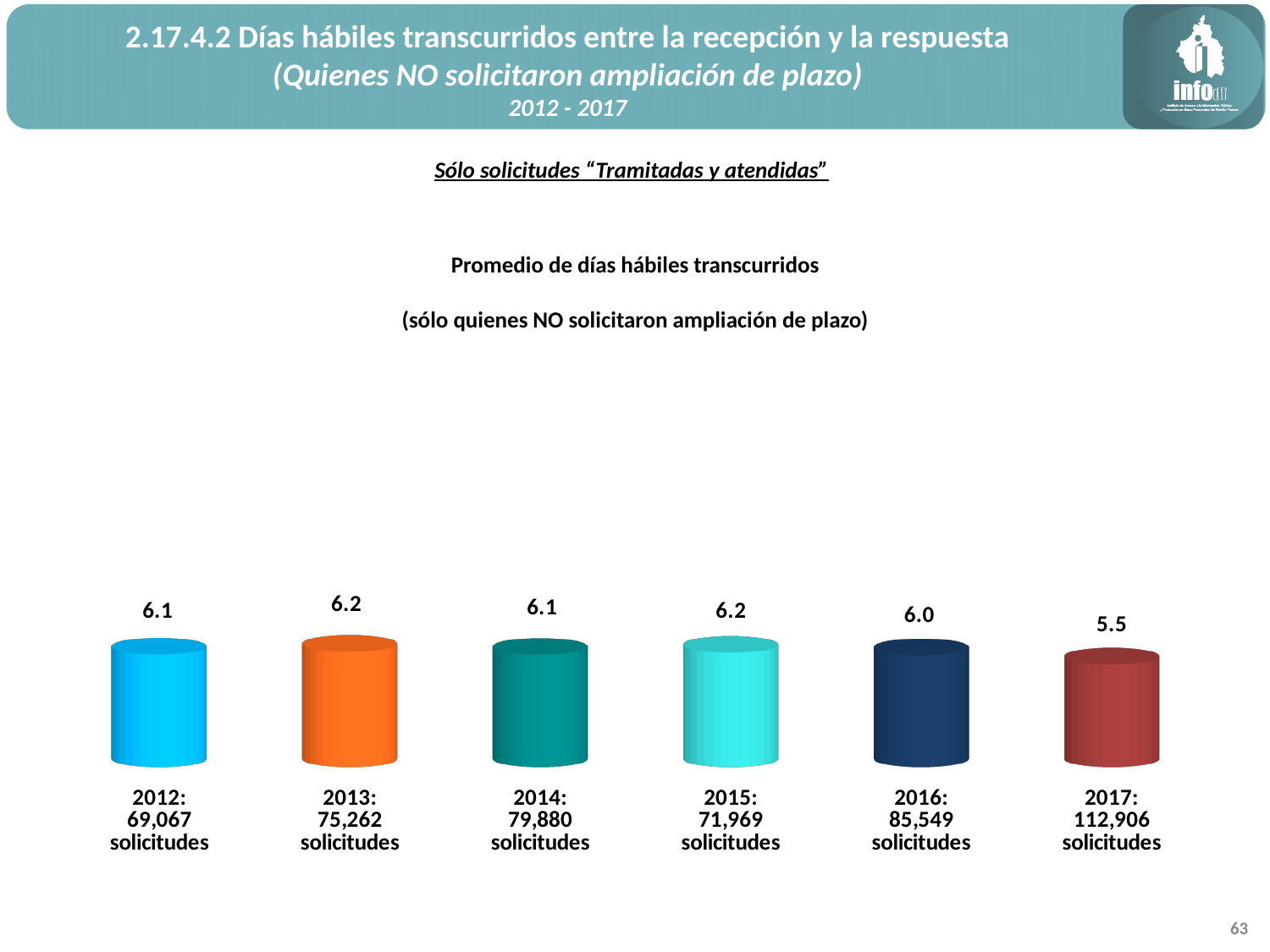
What kind of chart is shown on the slide? bar chart Which year has the lowest average number of business days elapsed? 2017 What is the average number of business days elapsed for 2016? 6.0 Which is larger, the average days for 2015 or for 2016? 2015 What colour is the bar for 2013? orange What is the difference between the average days for 2013 and 2017? 0.7 How many solicitudes are reported for 2017? 112,906 What is the average number of business days elapsed for 2012? 6.1 How many years are shown in the chart? 6 What is the average number of business days elapsed for 2017? 5.5 What is the difference between the average days for 2016 and 2017? 0.5 How many solicitudes are reported for 2014? 79,880